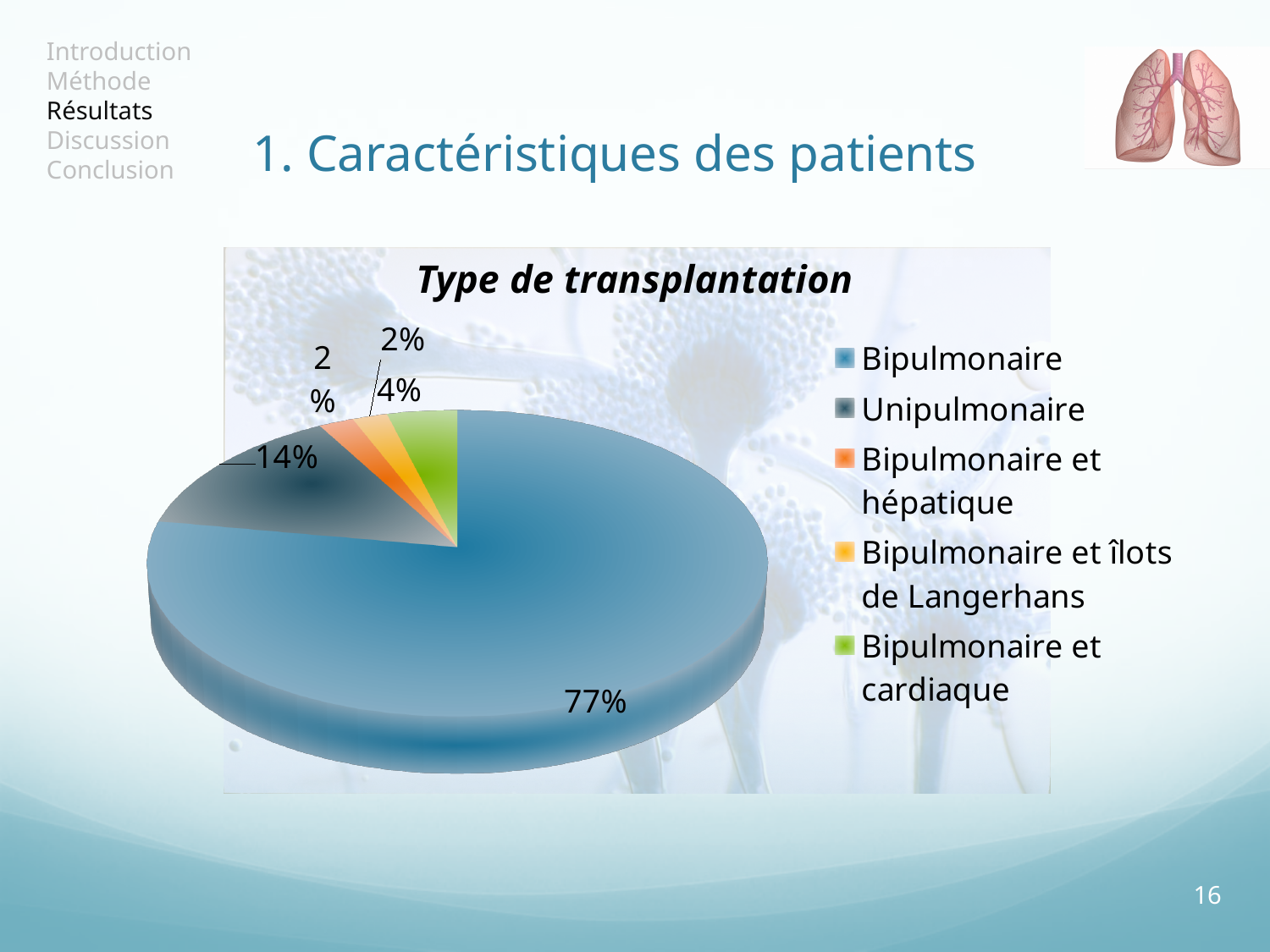
Which type of transplantation has the largest share of the pie chart? Bipulmonaire Which has a larger share: Unipulmonaire or Bipulmonaire et cardiaque? Unipulmonaire What is the difference in percentage points between Bipulmonaire and Unipulmonaire? 63 percentage points What percentage of the pie chart is Unipulmonaire? 14% What percentage of the pie chart is Bipulmonaire et îlots de Langerhans? 2% What percentage of the pie chart is Bipulmonaire et cardiaque? 4% How many categories does the pie chart show? 5 What is the title of the chart? Type de transplantation What kind of chart is shown on the slide? Pie chart What percentage of the pie chart is Bipulmonaire et hépatique? 2% What is the combined share of Bipulmonaire et hépatique and Bipulmonaire et îlots de Langerhans? 4% What percentage of the pie chart is Bipulmonaire? 77%